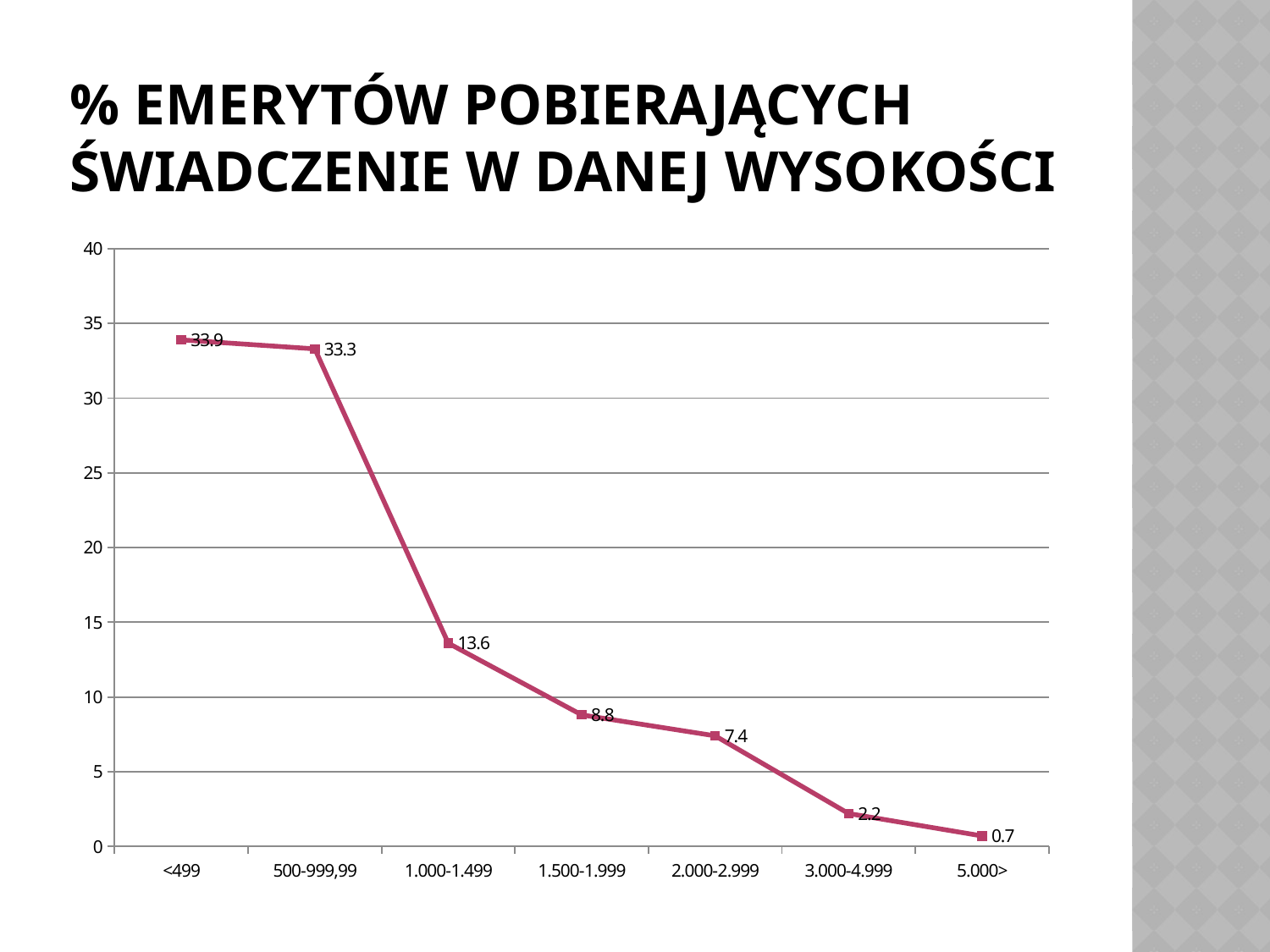
Which category has the highest value? <499 Which category has the lowest value? 5.000> What is the value for the 5.000> category? 0.7 What is the value for the 1.000-1.499 category? 13.6 Which is larger, the value for 1.500-1.999 or the value for 2.000-2.999? 1.500-1.999 Do the values rise or fall from left to right along the x axis? fall What is the difference between the values for 500-999,99 and 1.000-1.499? 19.7 How many categories are plotted on the x axis? 7 What kind of chart is shown on the slide? line chart What is the value for the <499 category? 33.9 What is the title of the slide? % EMERYTÓW POBIERAJĄCYCH ŚWIADCZENIE W DANEJ WYSOKOŚCI Is the value for 3.000-4.999 greater or less than 5? less